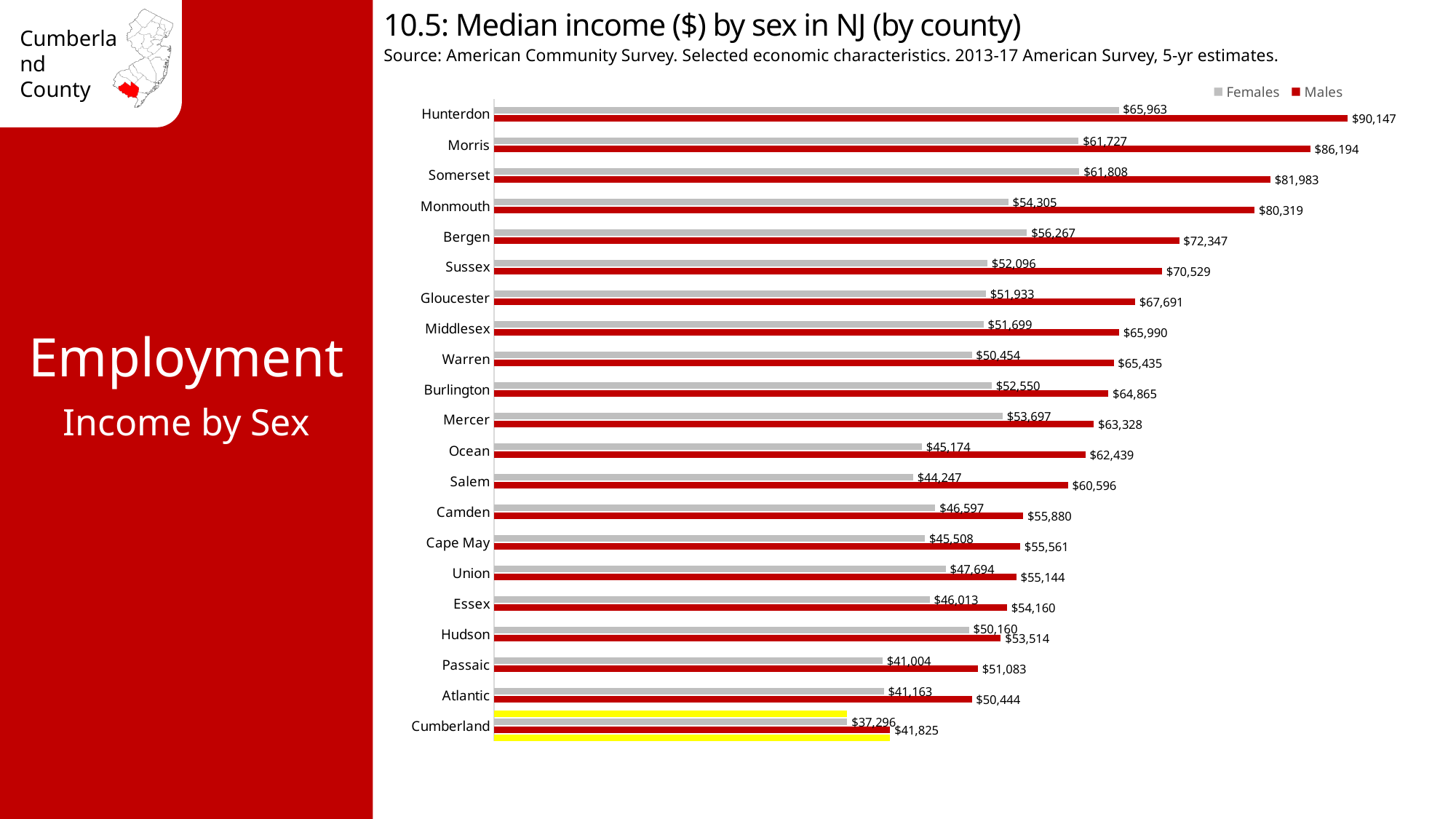
How many series does the legend list? 2 What type of chart is shown on the slide? bar chart Which is larger, the female median income in Bergen or in Monmouth? Bergen What is the median income for females in Salem? $44,247 Which county has the highest median income for males? Hunterdon How many counties are shown in the chart? 21 Which county has the lowest median income for females? Cumberland Which county's bars are highlighted in yellow on the chart? Cumberland What is the difference between male and female median income in Cumberland? $4,529 What is the median income for males in Gloucester? $67,691 What is the median income for males in Hudson? $53,514 What is the difference between male and female median income in Hunterdon? $24,184